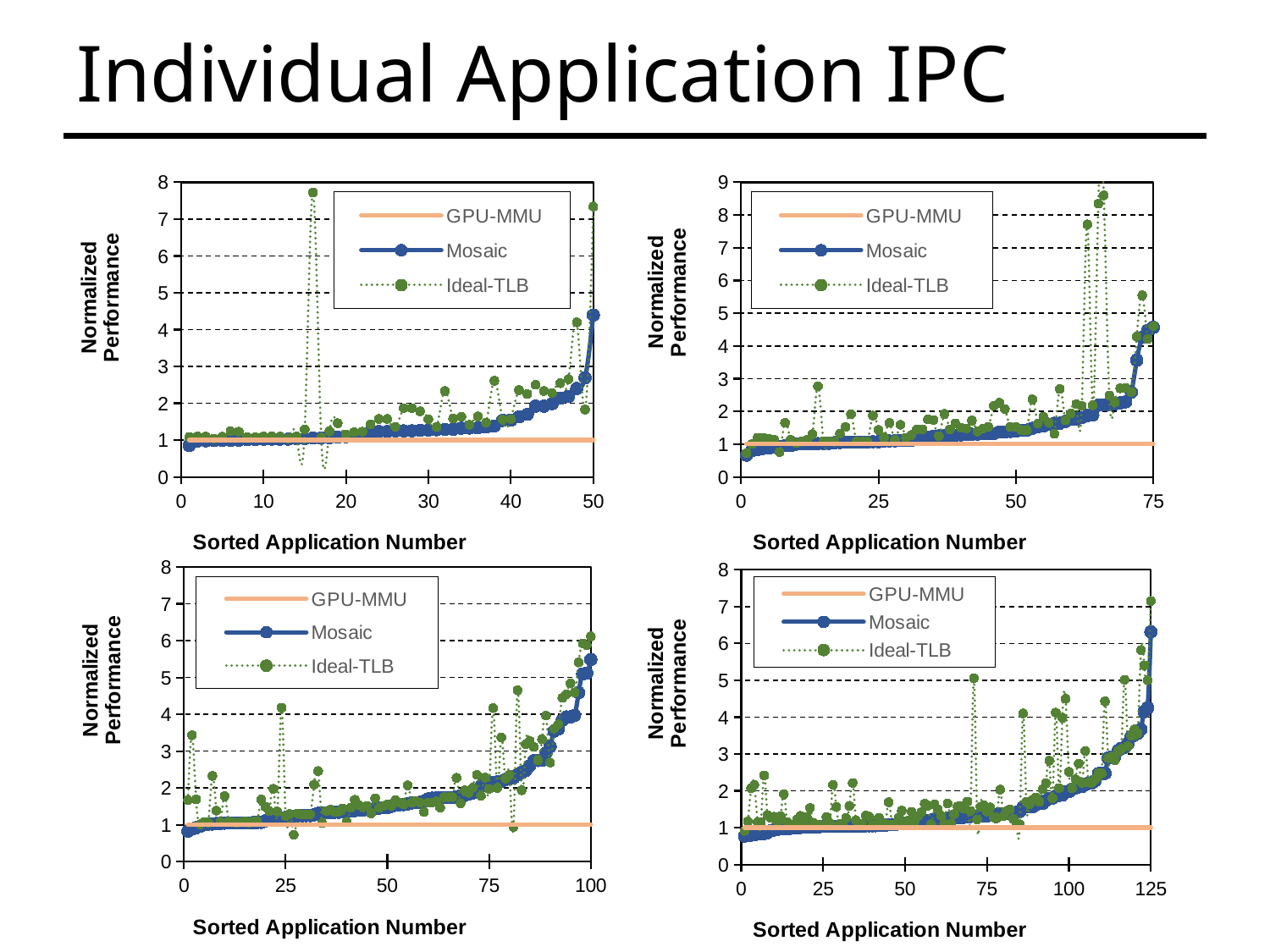
In the bottom-left chart, does the Mosaic series rise or fall as the sorted application number increases? rise How many series does the legend list in the top-left chart? 3 In the top-left chart, is the Mosaic value at sorted application number 50 greater or less than 3? greater In the bottom-left chart, is the Mosaic value at sorted application number 100 greater or less than 5? greater In the bottom-right chart, is the Mosaic value at sorted application number 125 greater or less than 5? greater In the top-left chart, which series reaches the highest value on the chart? Ideal-TLB What kind of chart is the top-left chart? line chart What is the y-axis title of the top-left chart? Normalized Performance In the bottom-left chart, at sorted application number 100, which is higher, Mosaic or Ideal-TLB? Ideal-TLB What is the x-axis title of the bottom-right chart? Sorted Application Number